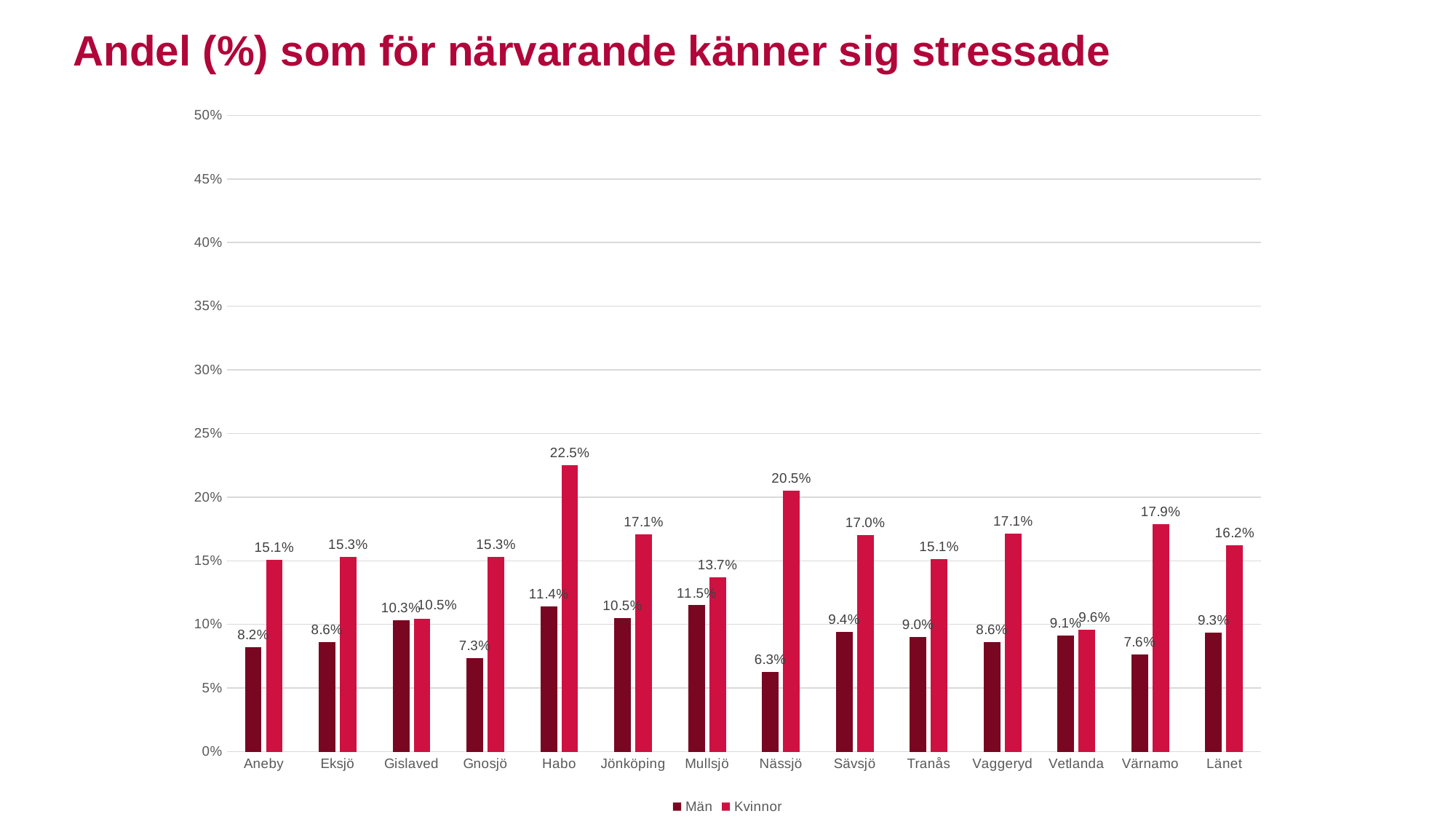
How many series does the legend list? 2 What is the value for Män in Nässjö? 6.3% What kind of chart is shown on the slide? Bar chart What is the difference between the Kvinnor and Män values in Habo? 11.1 percentage points Which category has the highest value for Kvinnor? Habo Which category has the lowest value for Män? Nässjö Which category has the lowest value for Kvinnor? Vetlanda What is the value for Kvinnor in Länet? 16.2% Which is larger in Nässjö, the value for Män or the value for Kvinnor? Kvinnor Is the value for Kvinnor in Värnamo greater or less than 15%? greater How many categories are shown on the x axis? 14 What is the value for Kvinnor in Habo? 22.5%